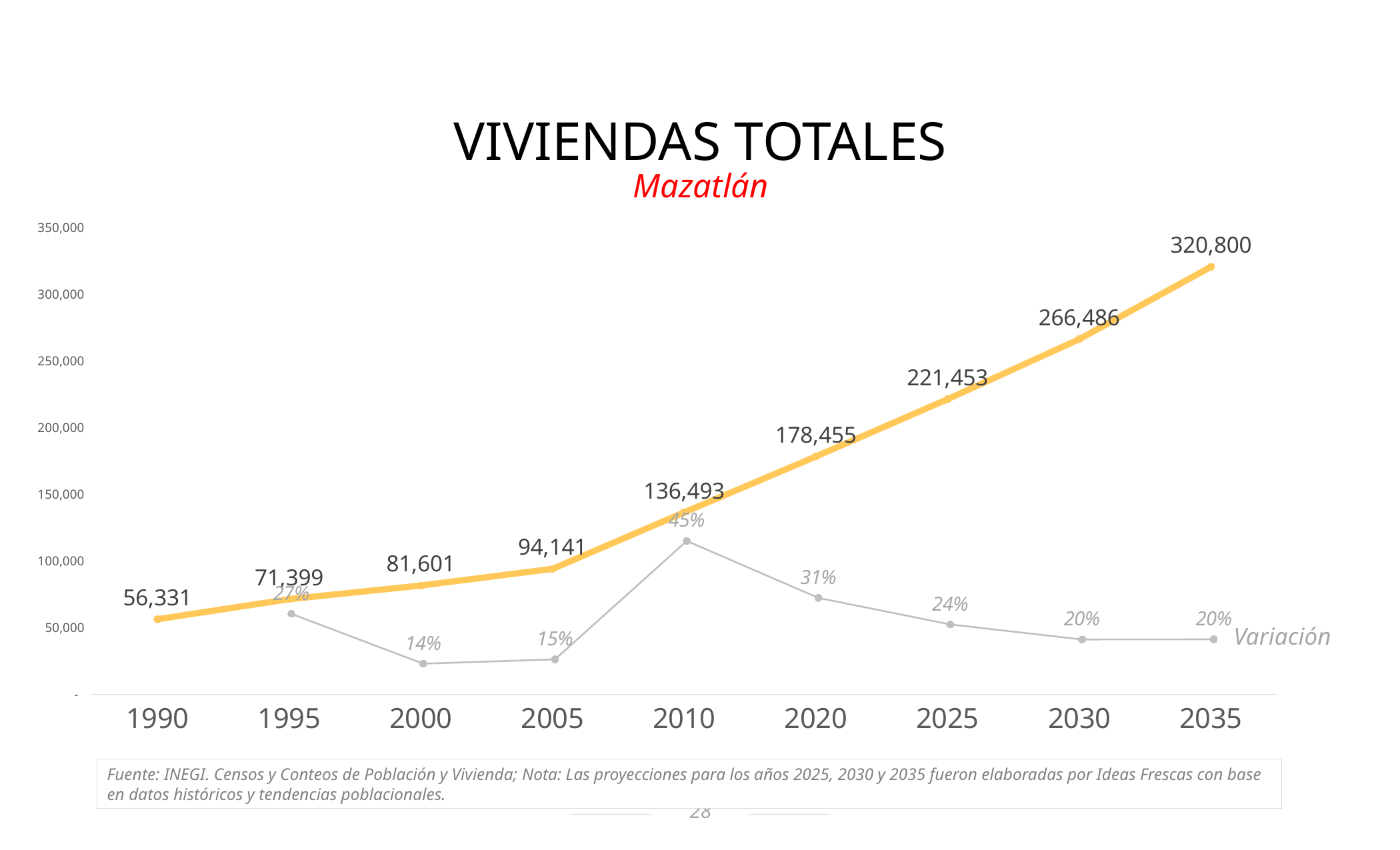
What is the projected value of viviendas totales for 2035? 320,800 What is the value of viviendas totales for 1990? 56,331 Do the viviendas totales values rise or fall from 1990 to 2035? rise What is the Variación percentage shown for 2010? 45% What is the difference in viviendas totales between 2035 and 2030? 54,314 Which is larger, the viviendas totales value for 2005 or for 2010? 2010 Is the viviendas totales value for 2020 greater or less than 150,000? greater Which year has the lowest Variación percentage? 2000 What kind of chart is shown on the slide? line chart What is the value of viviendas totales for 2010? 136,493 Which year has the highest value of viviendas totales? 2035 How many years are shown on the x axis? 9